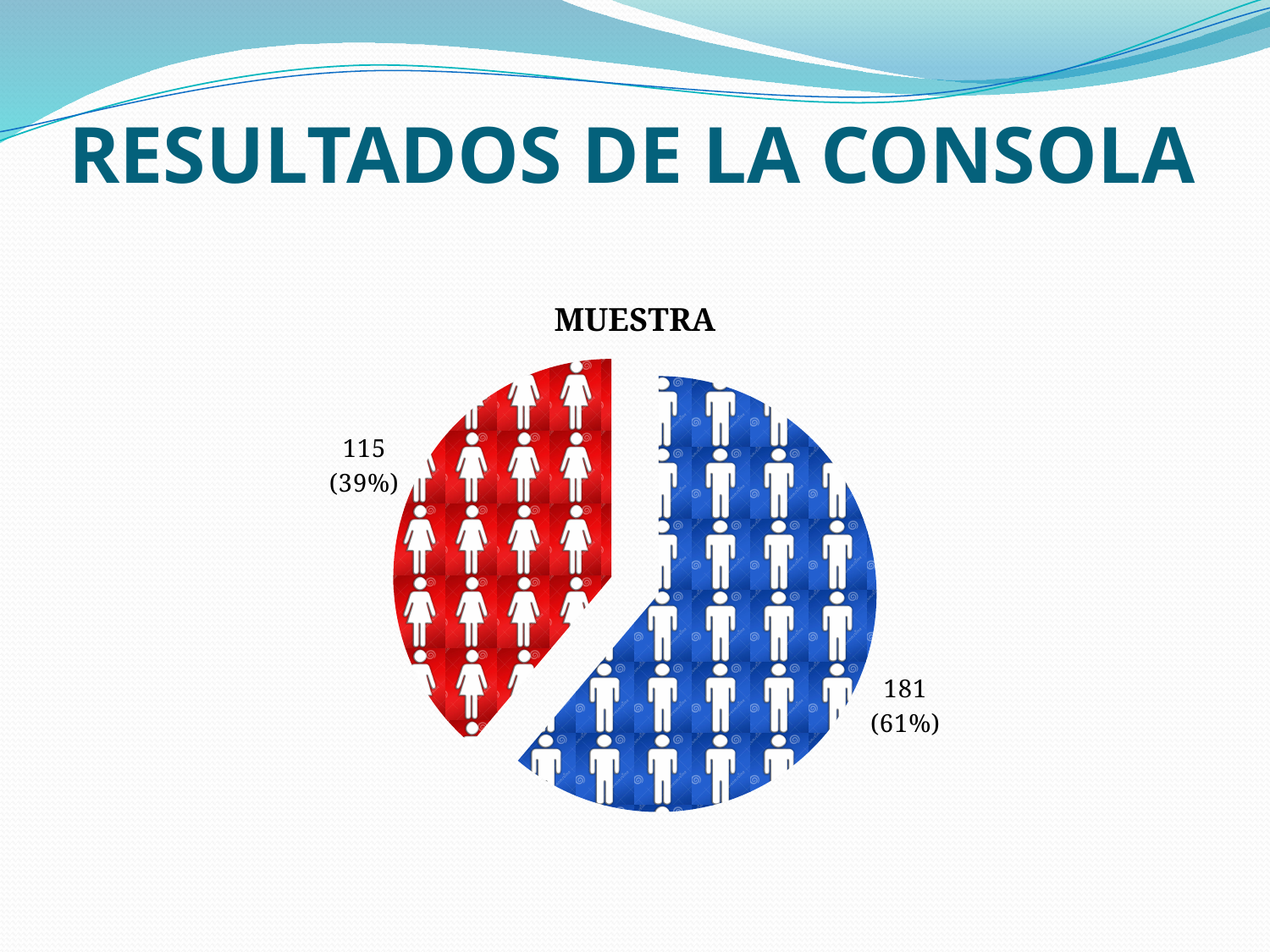
Which slice of the pie chart is the smallest? the red slice (115) What is the difference between the blue slice value and the red slice value? 66 What value is labelled on the blue slice of the pie chart? 181 What kind of chart is shown under the title MUESTRA? pie chart Which slice of the pie chart is the largest? the blue slice (181) What value is labelled on the red slice of the pie chart? 115 What percentage share does the red slice represent? 39% Is the blue slice larger or smaller than the red slice? larger How many slices does the MUESTRA pie chart have? 2 What percentage share does the blue slice represent? 61% What is the title of the chart? MUESTRA What is the total of the two slice values in the pie chart? 296